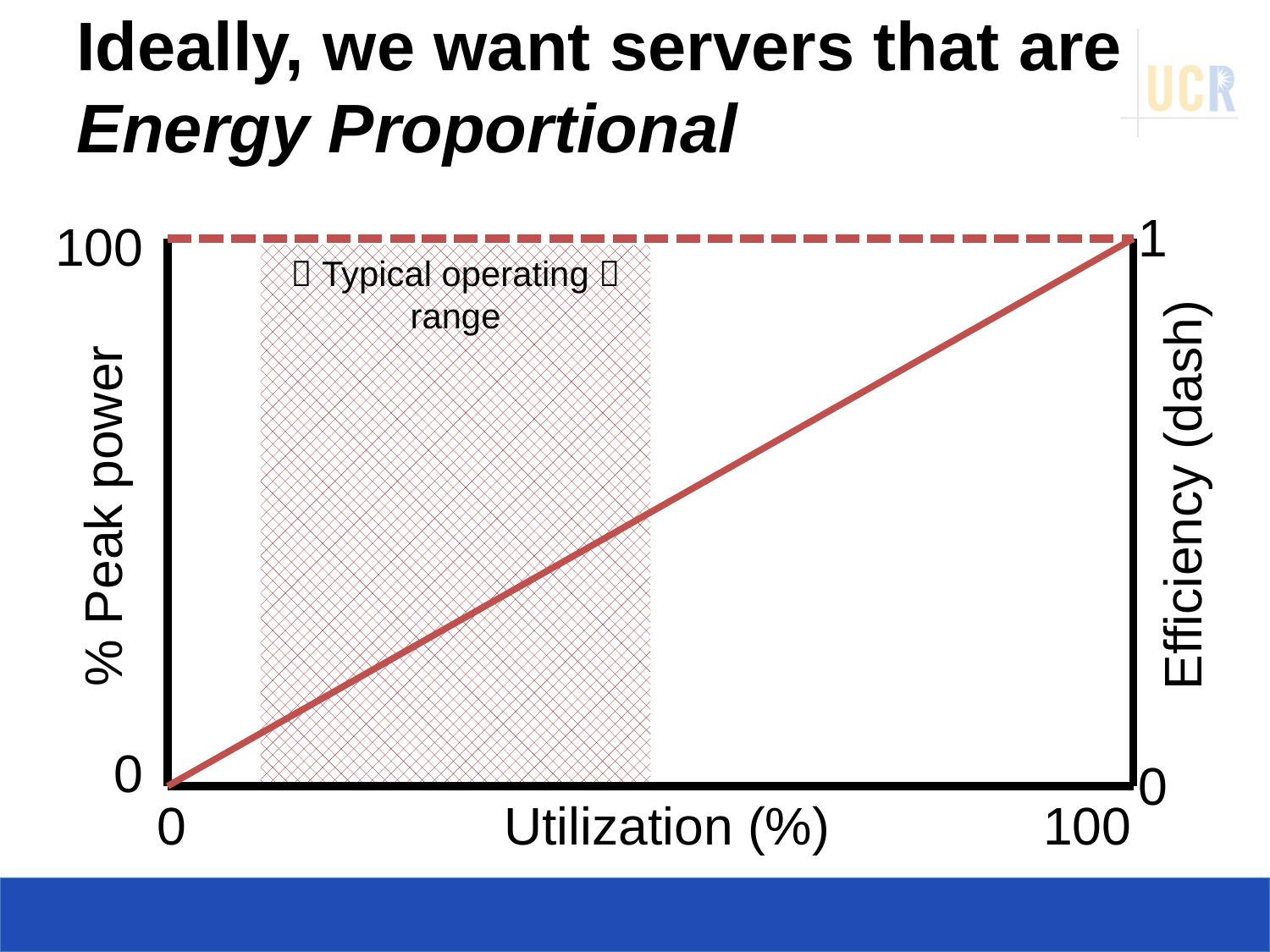
What is the % Peak power value of the solid line at 100% utilization? 100 Does the solid % Peak power line rise or fall as utilization increases? rises Does the dashed efficiency line rise, fall, or stay flat as utilization increases? stays flat What is the maximum value shown on the left y axis (% Peak power)? 100 What kind of chart is shown on the slide? line chart What is the % Peak power value of the solid line at 0% utilization? 0 What efficiency value does the dashed line stay at across the utilization range? 1 What is the label of the right-hand y axis? Efficiency (dash) How many lines are plotted on the chart? 2 What is the label of the x axis? Utilization (%) What is the maximum value shown on the right y axis (Efficiency)? 1